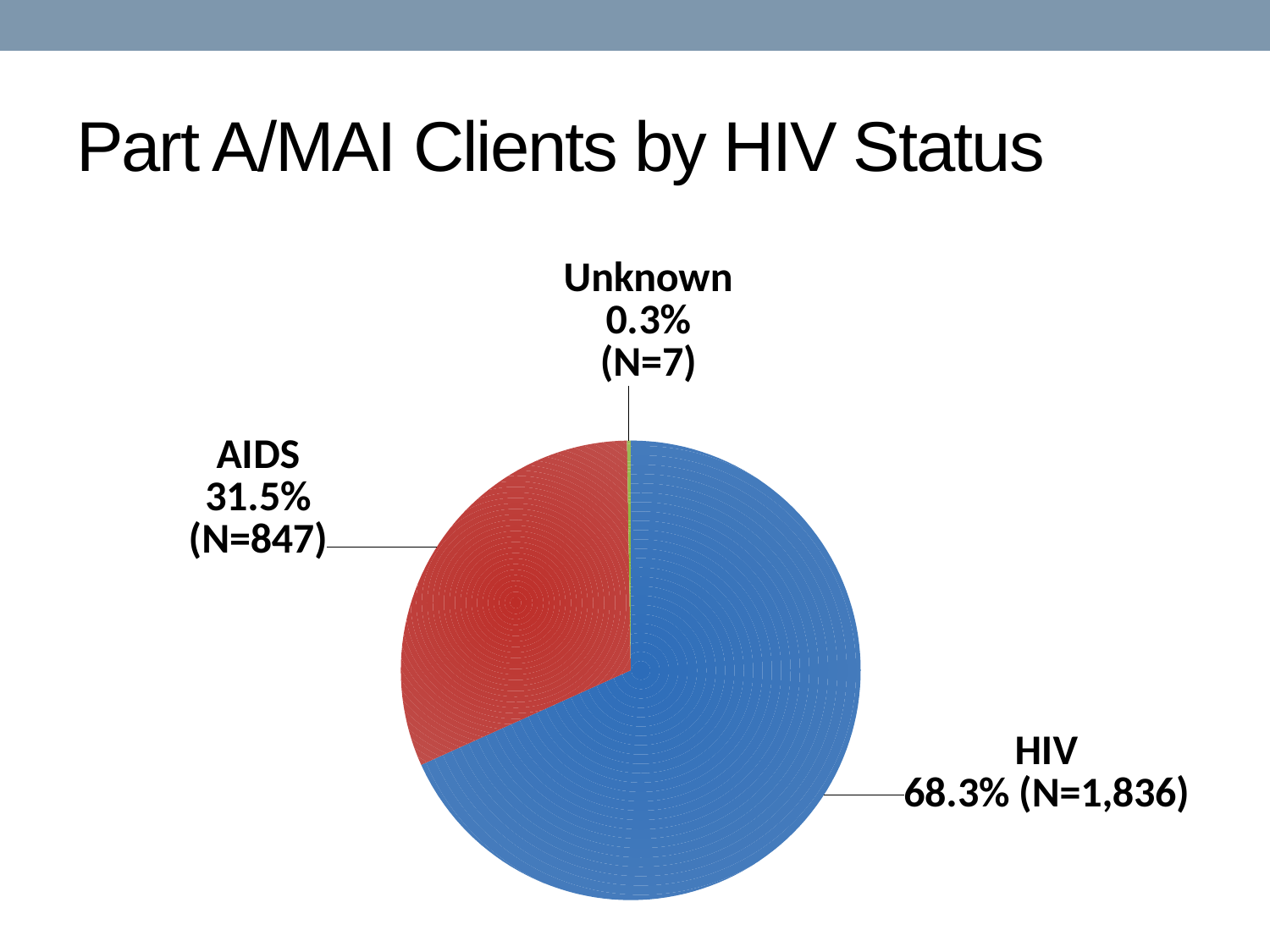
How many clients are in the AIDS category? 847 What type of chart is shown on the slide? pie chart How many clients are in the HIV category? 1,836 What is the title of the chart? Part A/MAI Clients by HIV Status Which HIV status category has the largest share of clients? HIV What percentage of clients have AIDS status? 31.5% How many categories are shown in the pie chart? 3 What is the difference in percentage points between the HIV and AIDS slices? 36.8 What percentage of clients have Unknown status? 0.3% What percentage of clients have HIV status? 68.3% Which HIV status category has the smallest share of clients? Unknown How many clients are in the Unknown category? 7